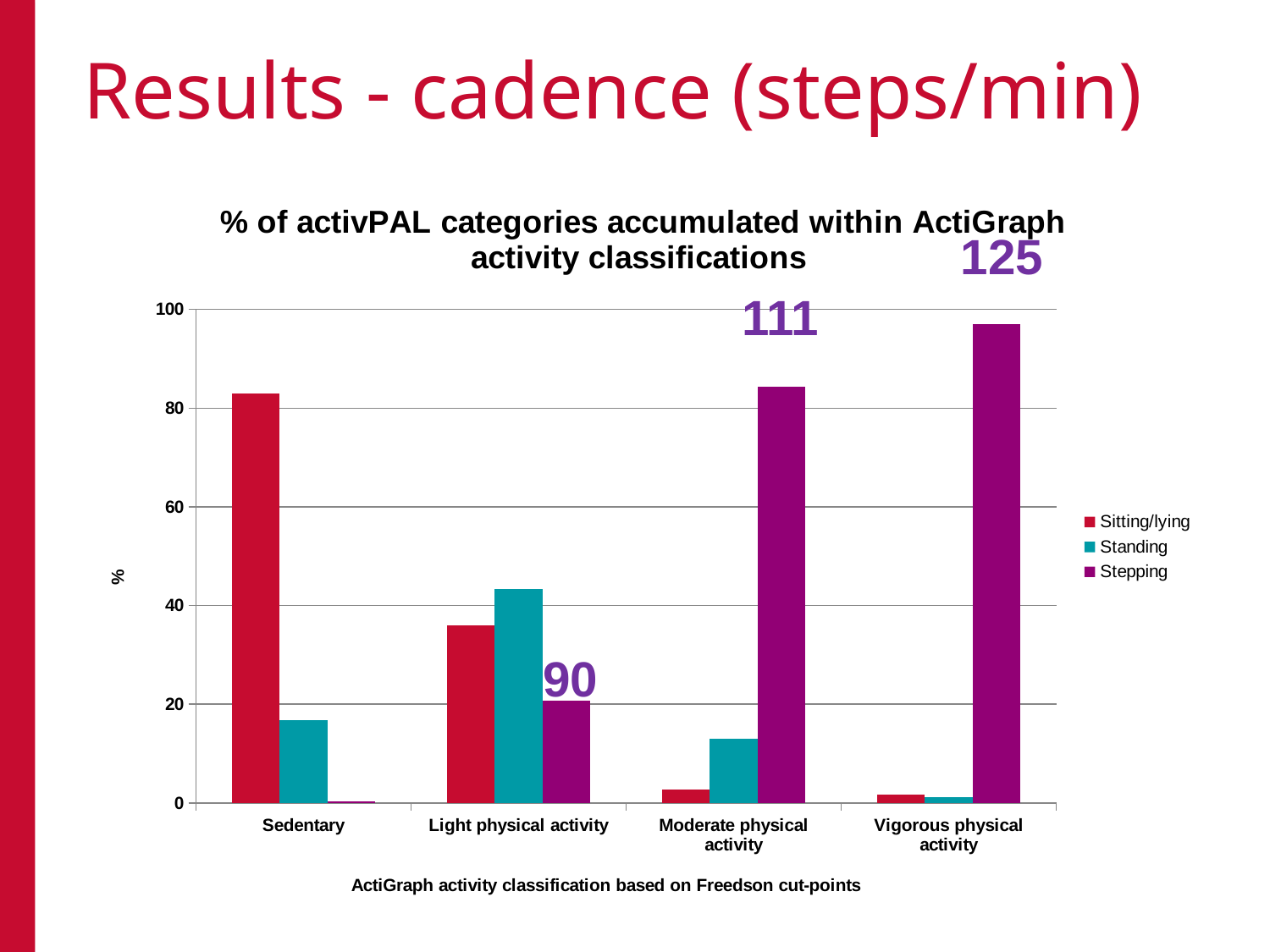
How many ActiGraph activity classification categories are shown on the x axis? 4 What is the x-axis title of the chart? ActiGraph activity classification based on Freedson cut-points Within the Sedentary category, which series has the highest value? Sitting/lying Is the Stepping value for Moderate physical activity greater or less than 60? greater Which is larger: the Stepping value for Vigorous physical activity or for Moderate physical activity? Vigorous physical activity What kind of chart is shown on the slide? bar chart Which ActiGraph category has the highest Stepping value? Vigorous physical activity How many series does the legend list? 3 Is the Sitting/lying value for Sedentary greater or less than 60? greater Which ActiGraph category has the lowest Stepping value? Sedentary Within Light physical activity, which is larger: Standing or Sitting/lying? Standing Is the Stepping value for Light physical activity greater or less than 40? less